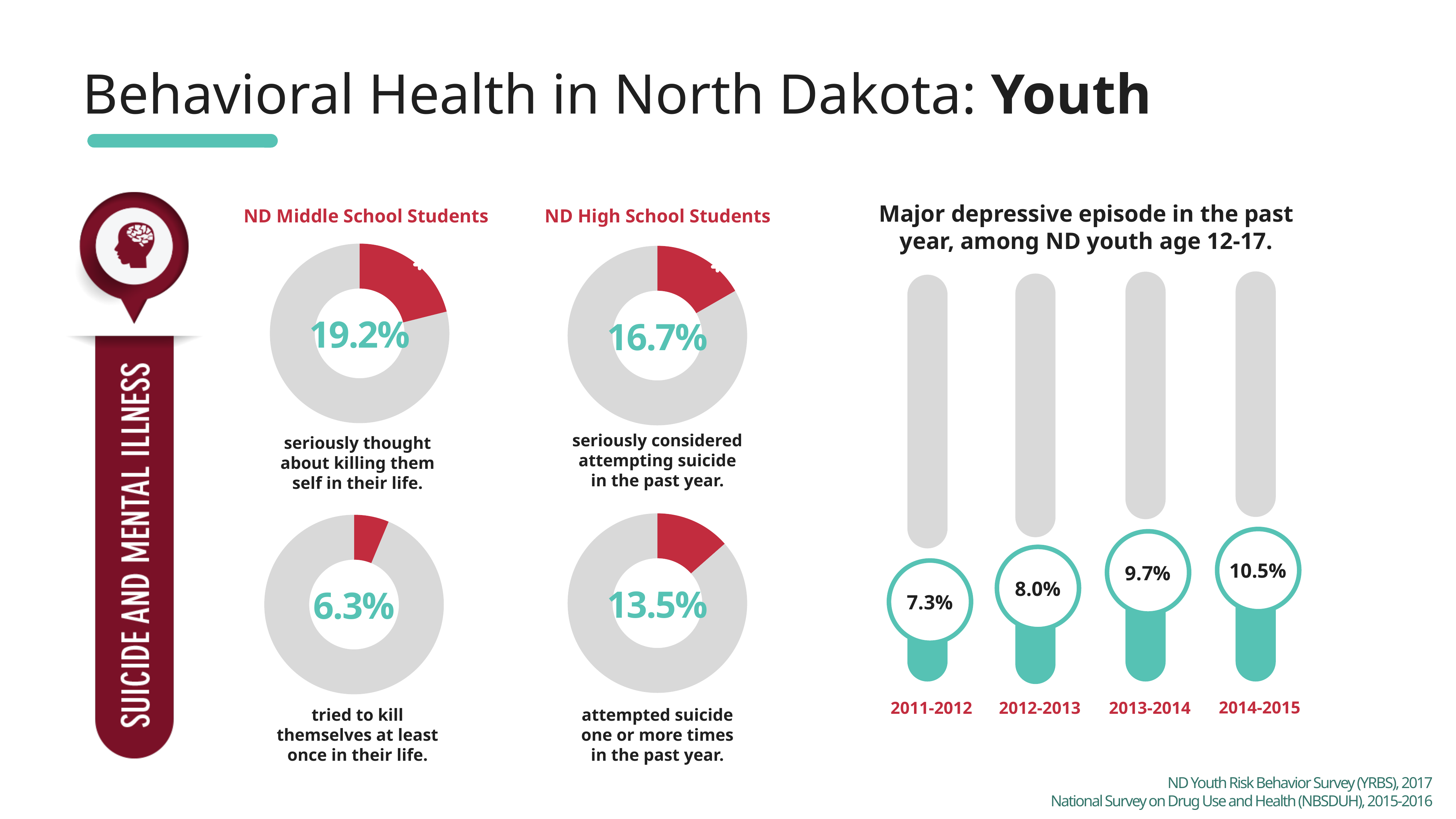
Comparing the top donut charts, which is larger: the ND Middle School Students value (19.2%) or the ND High School Students value (16.7%)? ND Middle School Students In the 'Major depressive episode in the past year, among ND youth age 12-17' chart, which is larger: the value for 2012-2013 or 2013-2014? 2013-2014 In the top ND Middle School Students donut chart, what percentage of students seriously thought about killing themselves in their life? 19.2% In the bottom ND High School Students donut chart, what percentage of students attempted suicide one or more times in the past year? 13.5% In the bottom ND Middle School Students donut chart, what percentage of students tried to kill themselves at least once in their life? 6.3% In the 'Major depressive episode in the past year, among ND youth age 12-17' chart, which period has the lowest value? 2011-2012 In the 'Major depressive episode in the past year, among ND youth age 12-17' chart, do the values rise or fall from 2011-2012 to 2014-2015? rise In the 'Major depressive episode in the past year, among ND youth age 12-17' chart, what is the value for 2011-2012? 7.3% In the 'Major depressive episode in the past year, among ND youth age 12-17' chart, what is the value for 2014-2015? 10.5% In the 'Major depressive episode in the past year, among ND youth age 12-17' chart, which period has the highest value? 2014-2015 In the 'Major depressive episode in the past year, among ND youth age 12-17' chart, how many periods are shown? 4 In the 'Major depressive episode in the past year, among ND youth age 12-17' chart, what is the difference between the 2014-2015 and 2011-2012 values? 3.2%